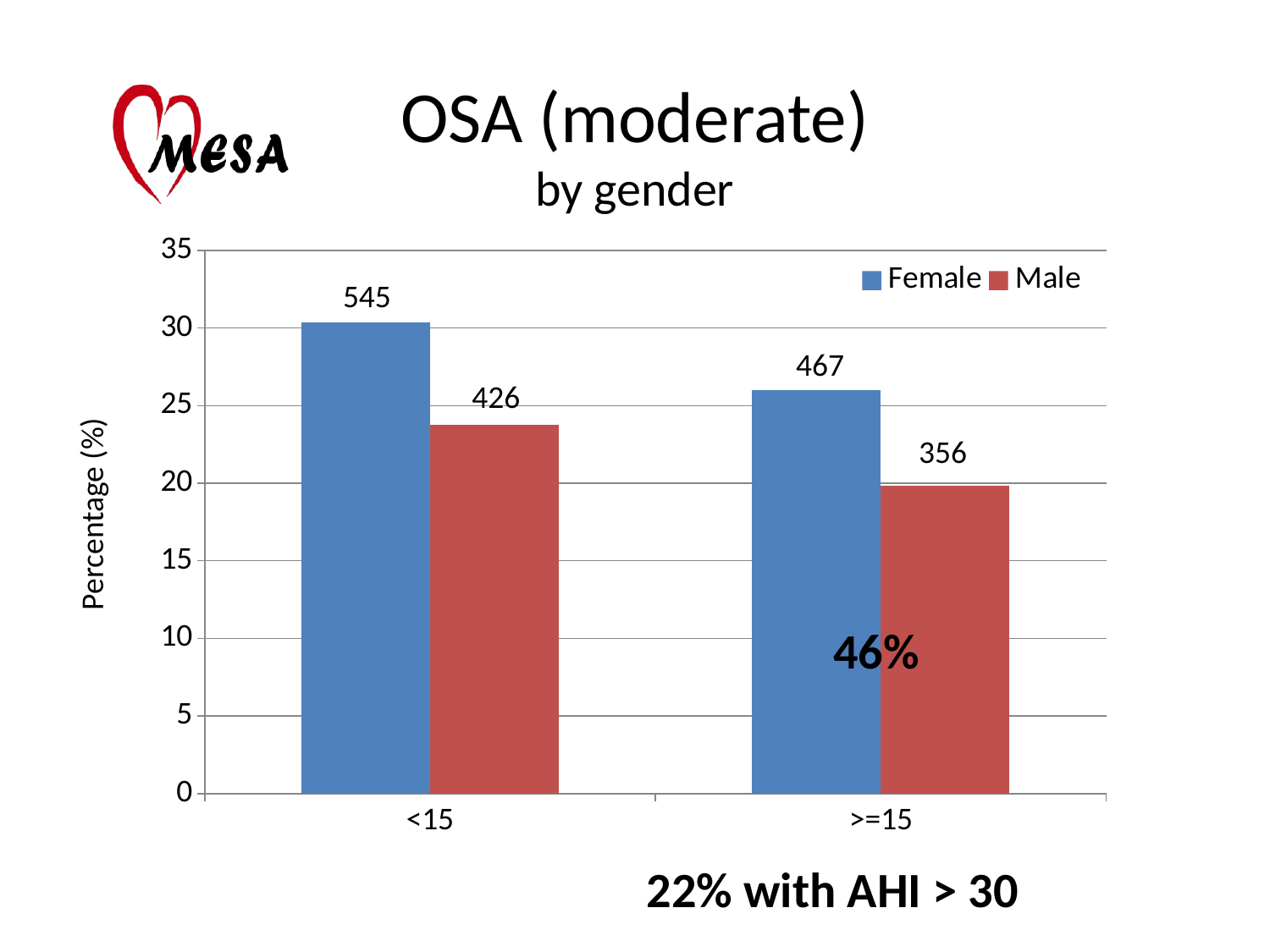
How many categories are shown on the x axis? 2 What data label is printed above the Female bar for the <15 category? 545 What data label is printed above the Female bar for the >=15 category? 467 How many series does the legend list? 2 Which bar is the tallest in the chart? Female, <15 What is the label of the y axis? Percentage (%) Is the Male bar for the >=15 category greater or less than 25 on the percentage axis? less What is the difference between the Female and Male data labels in the <15 category? 119 What data label is printed above the Male bar for the <15 category? 426 What type of chart is shown on the slide? bar chart What data label is printed above the Male bar for the >=15 category? 356 Which bar is the shortest in the chart? Male, >=15